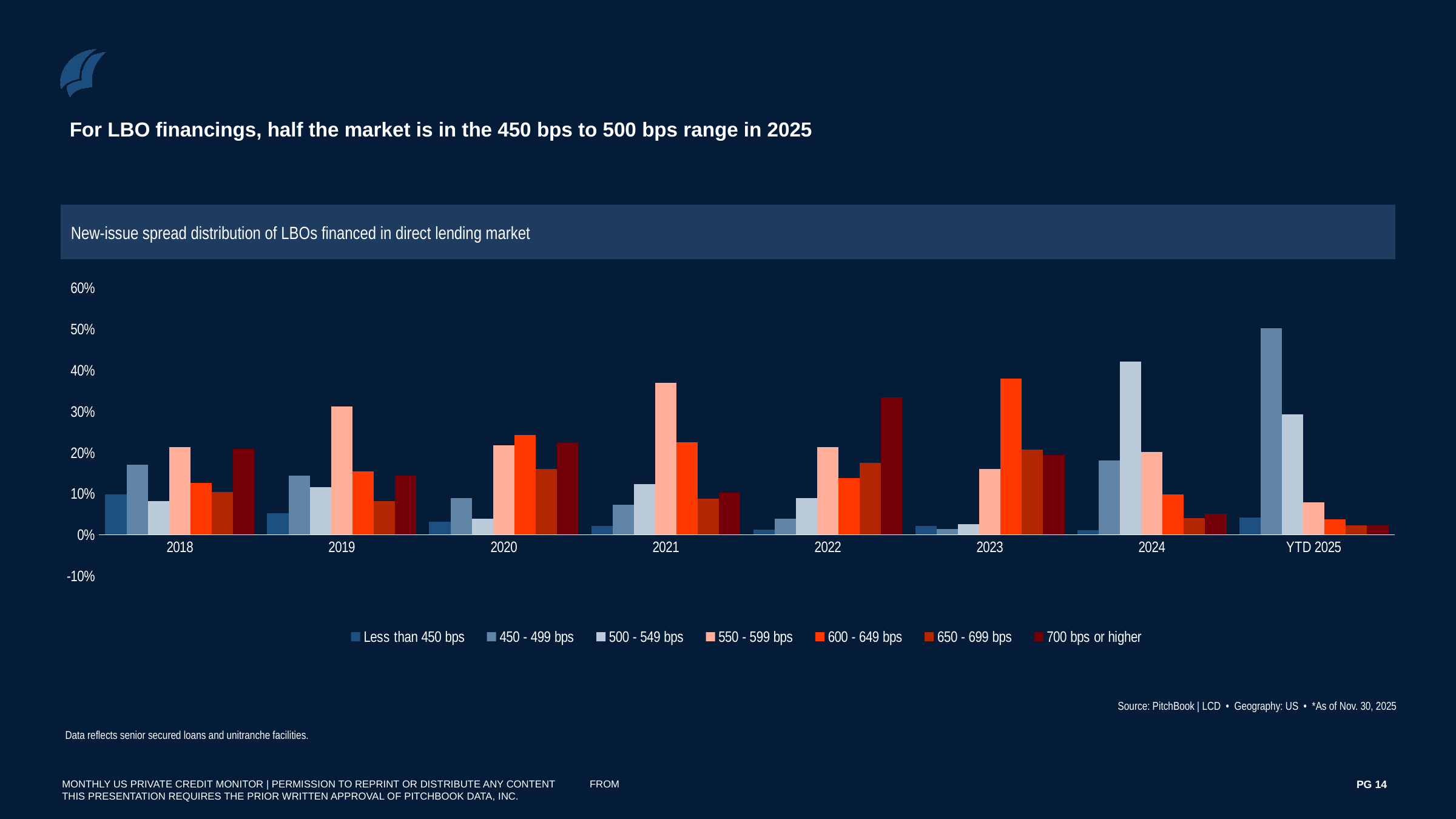
Is the value for 550 - 599 bps in 2021 greater or less than 30%? greater In 2023, which is larger: the 600 - 649 bps bar or the 550 - 599 bps bar? 600 - 649 bps How many year categories are shown on the x axis? 8 What is the title of the chart? New-issue spread distribution of LBOs financed in direct lending market How many series does the legend list? 7 Is the value for 450 - 499 bps in YTD 2025 greater or less than 40%? greater In which year is the 450 - 499 bps bar the highest? YTD 2025 In 2022, which spread range has the highest bar? 700 bps or higher In 2024, which spread range has the lowest bar? Less than 450 bps Does the 450 - 499 bps series rise or fall from 2023 to YTD 2025? rise What kind of chart is shown on the slide? bar chart Is the value for 500 - 549 bps in 2024 greater or less than 30%? greater